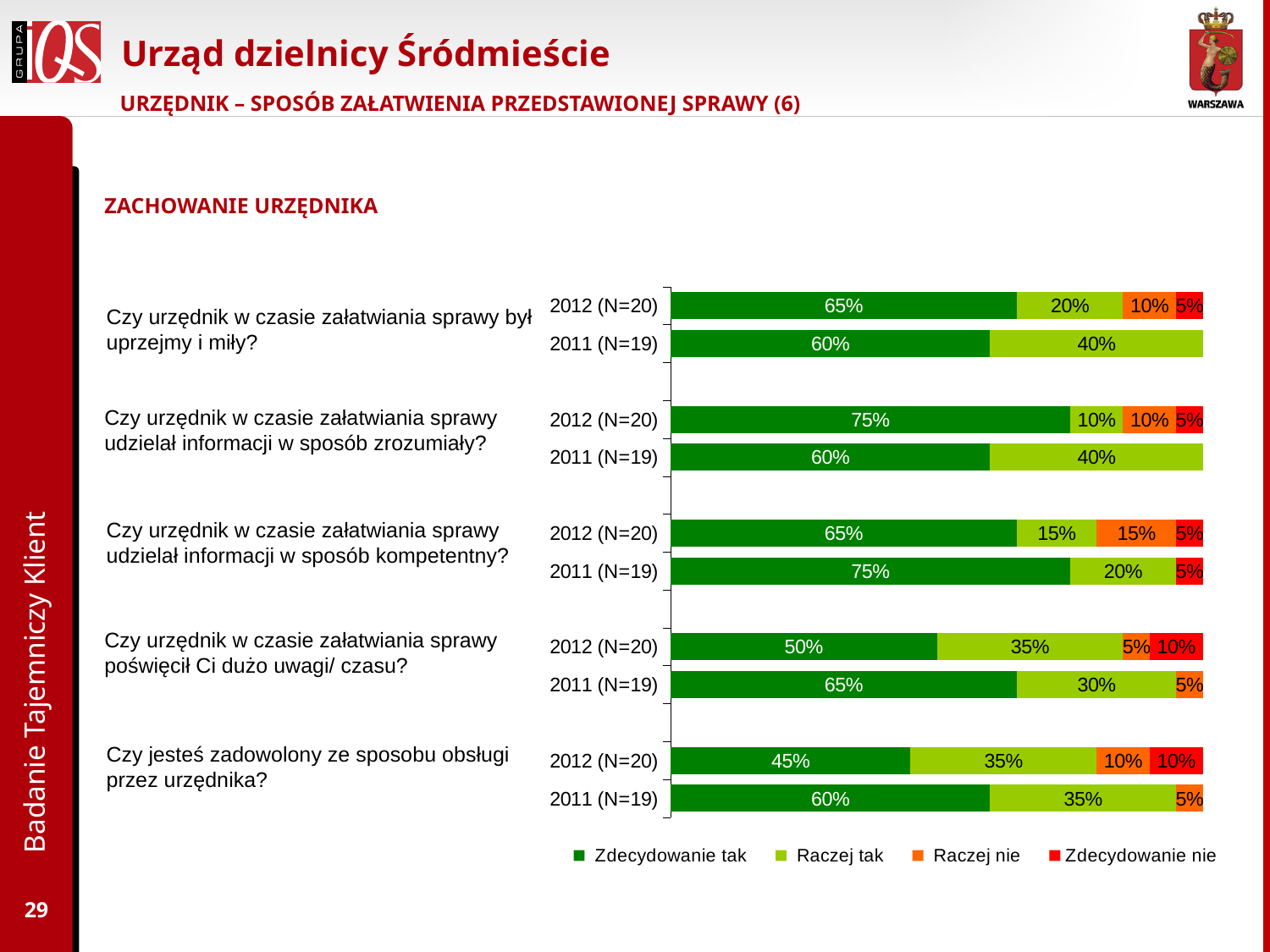
For the question 'Czy urzędnik w czasie załatwiania sprawy udzielał informacji w sposób kompetentny?', what is the difference between the 'Zdecydowanie tak' values for 2011 (N=19) and 2012 (N=20)? 10% What is the 'Zdecydowanie tak' value for 2012 (N=20) for the question 'Czy jesteś zadowolony ze sposobu obsługi przez urzędnika?' 45% What is the 'Zdecydowanie nie' value for 2012 (N=20) for the question 'Czy urzędnik w czasie załatwiania sprawy poświęcił Ci dużo uwagi/ czasu?' 10% Which 2012 (N=20) bar has the highest 'Zdecydowanie tak' value? Czy urzędnik w czasie załatwiania sprawy udzielał informacji w sposób zrozumiały? For the question 'Czy urzędnik w czasie załatwiania sprawy poświęcił Ci dużo uwagi/ czasu?', which year has the larger 'Zdecydowanie tak' value, 2012 (N=20) or 2011 (N=19)? 2011 (N=19) How many series does the legend list? 4 What is the 'Raczej tak' value for 2011 (N=19) for the question 'Czy urzędnik w czasie załatwiania sprawy był uprzejmy i miły?' 40% What is the combined share of 'Zdecydowanie tak' and 'Raczej tak' for 2012 (N=20) for the question 'Czy jesteś zadowolony ze sposobu obsługi przez urzędnika?' 80% What kind of chart is shown on the slide? Stacked bar chart Which legend entry is shown in red? Zdecydowanie nie What is the 'Zdecydowanie tak' value for 2012 (N=20) for the question 'Czy urzędnik w czasie załatwiania sprawy udzielał informacji w sposób zrozumiały?' 75% Which 2012 (N=20) bar has the lowest 'Zdecydowanie tak' value? Czy jesteś zadowolony ze sposobu obsługi przez urzędnika?